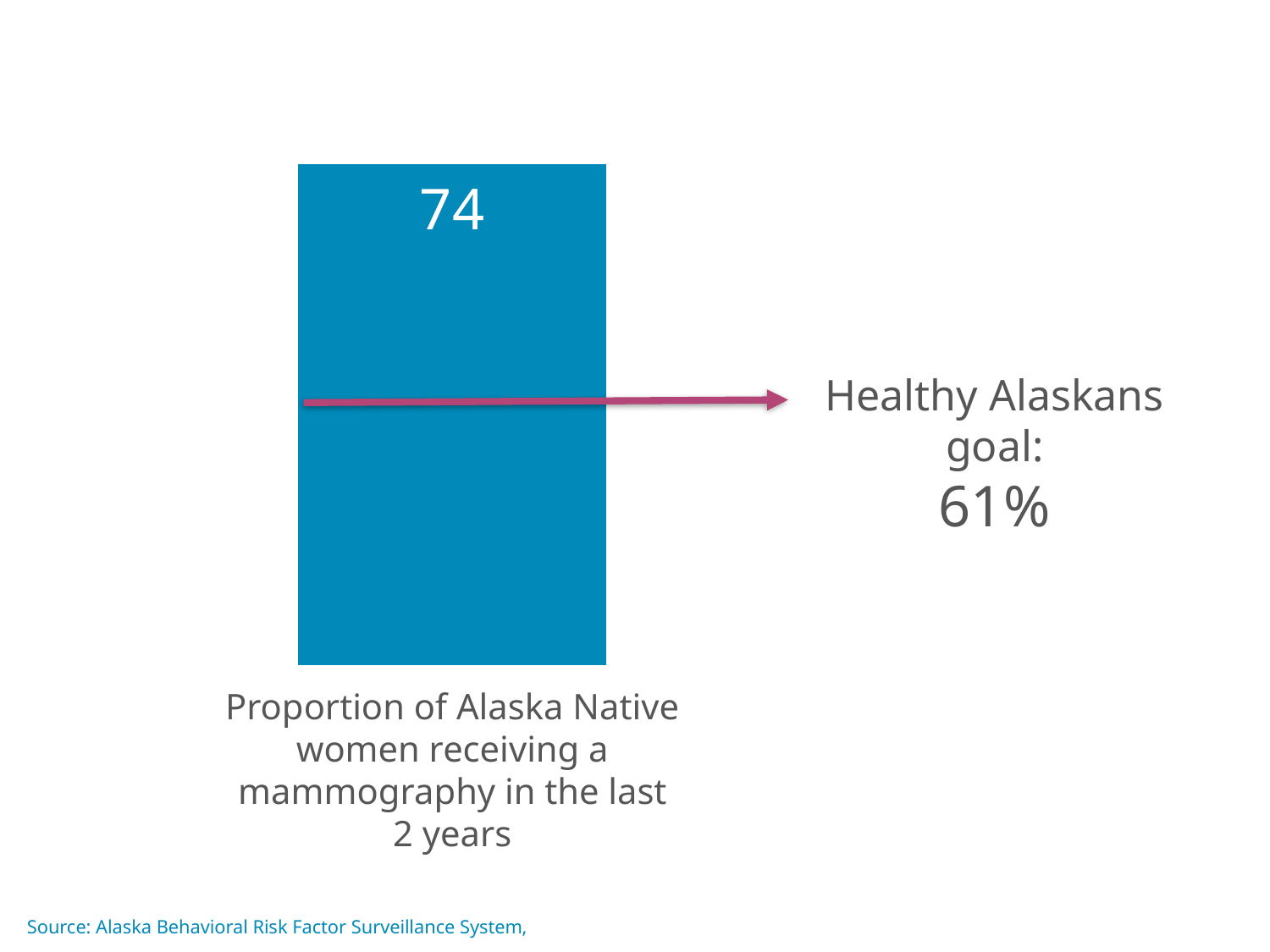
What is the category label under the bar? Proportion of Alaska Native women receiving a mammography in the last 2 years Is the value for the proportion of Alaska Native women receiving a mammography in the last 2 years greater or less than 70? greater What kind of chart is shown on the slide? bar chart How many bars are plotted in the chart? 1 What is the value shown on the bar for the proportion of Alaska Native women receiving a mammography in the last 2 years? 74 Is the plotted value for Alaska Native women receiving a mammography greater or less than the Healthy Alaskans goal of 61%? greater What is the Healthy Alaskans goal shown next to the chart? 61%